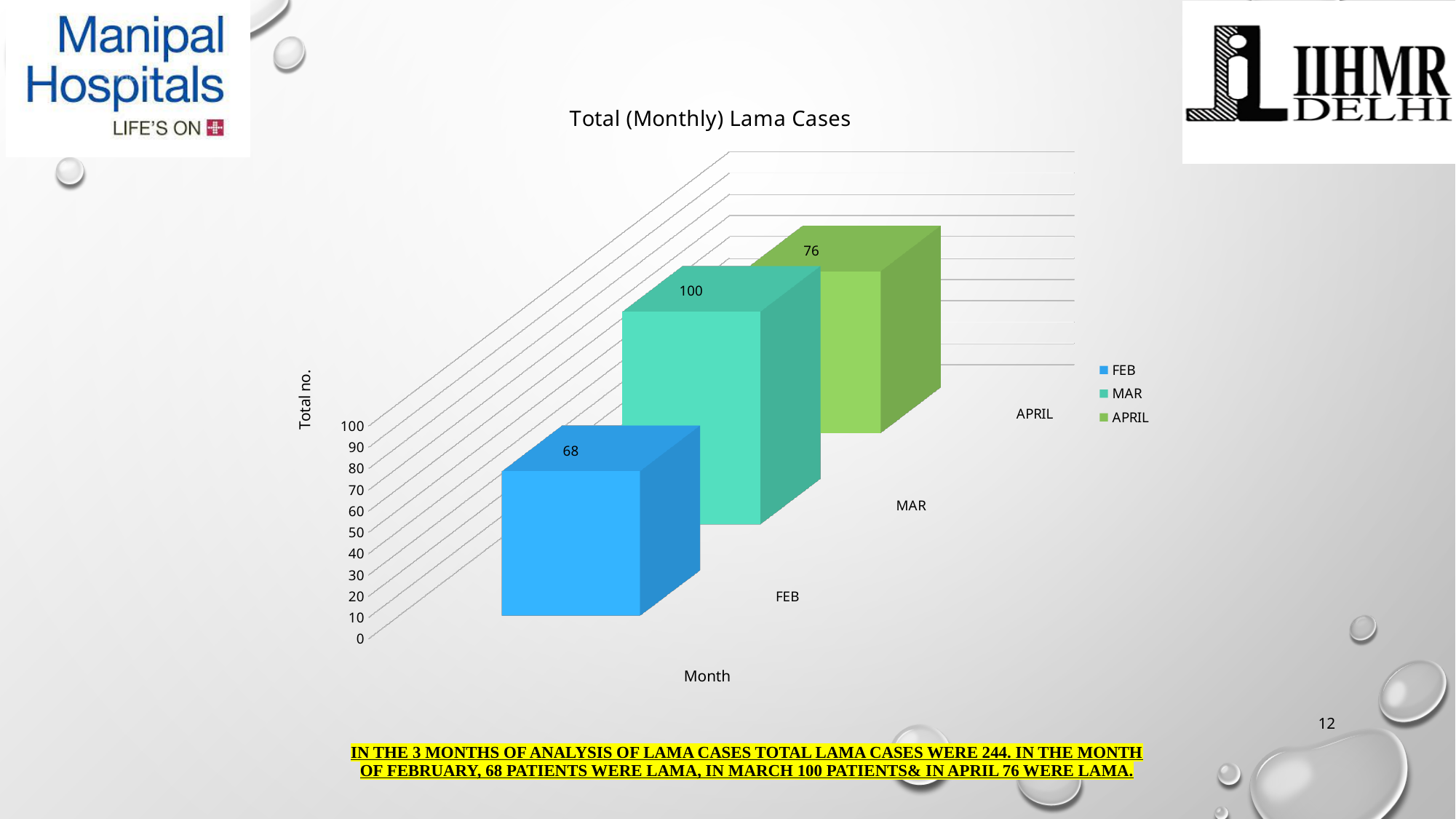
Which month has the lowest number of Lama cases? FEB What is the value for MAR in the Total (Monthly) Lama Cases chart? 100 What kind of chart is shown on the slide? Bar chart What is the value for FEB in the Total (Monthly) Lama Cases chart? 68 How many months are plotted in the chart? 3 Which month has the highest number of Lama cases? MAR What is the difference between the Lama cases in MAR and APRIL? 24 What is the title of the chart? Total (Monthly) Lama Cases What is the difference between the Lama cases in MAR and FEB? 32 Which is larger, the value for APRIL or the value for FEB? APRIL How many entries does the legend list? 3 What is the value for APRIL in the Total (Monthly) Lama Cases chart? 76